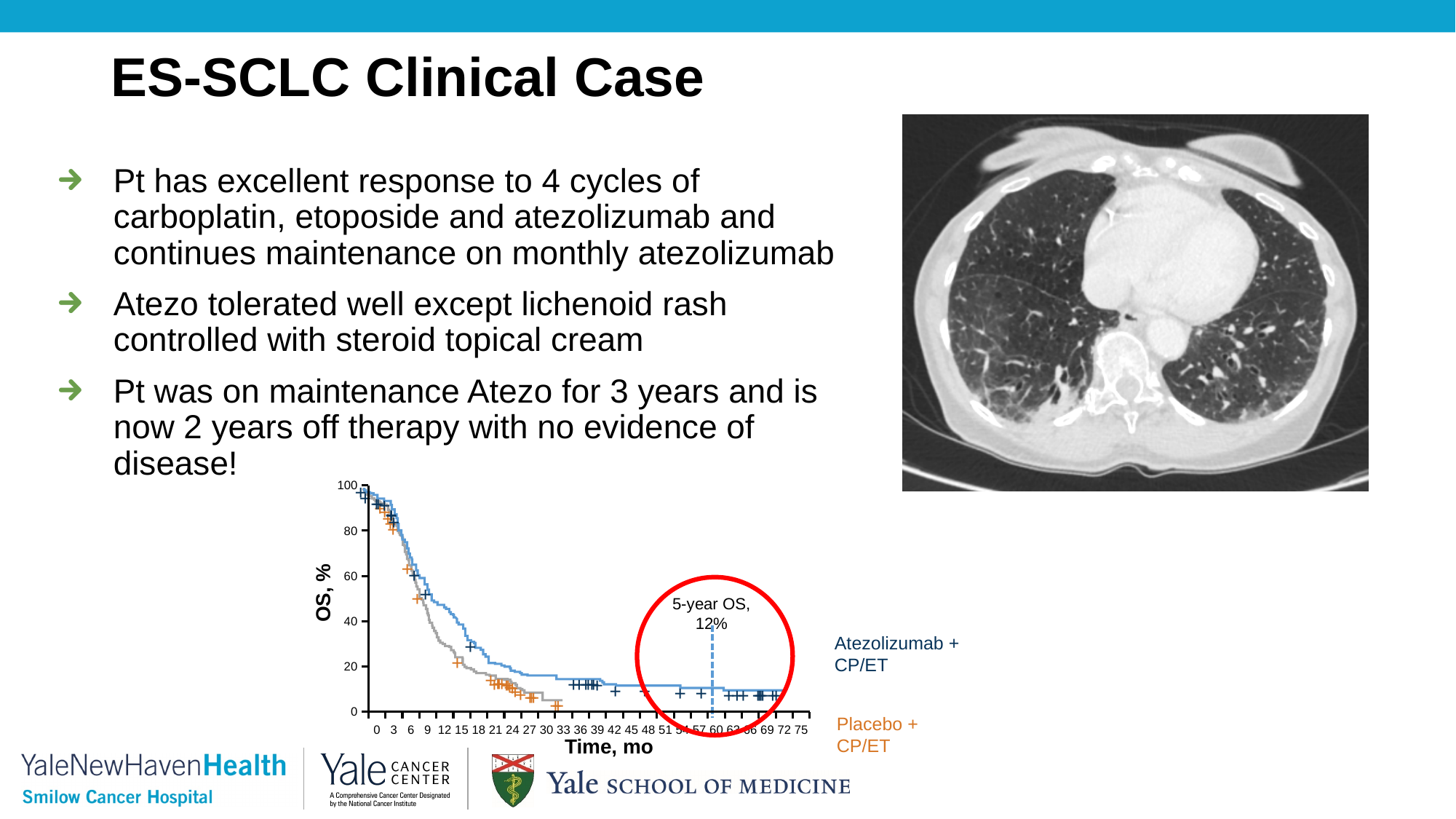
Is the OS value for Placebo + CP/ET at 30 months greater or less than 20? less What is the label of the y-axis on the survival chart? OS, % At 36 months, which series has the higher OS, Atezolizumab + CP/ET or Placebo + CP/ET? Atezolizumab + CP/ET Which series on the chart is labelled in orange text? Placebo + CP/ET Is the OS value for Atezolizumab + CP/ET at 60 months greater or less than 20? less At what time point (in months) is the dashed vertical line drawn on the chart? 60 Do the OS values rise or fall as time increases along the x axis? fall Is the OS value for Atezolizumab + CP/ET at 3 months greater or less than 80? greater What kind of chart is shown at the bottom of the slide? line chart What is the 5-year OS value highlighted in the red circle on the chart? 12% How many series (treatment arms) are shown on the survival chart? 2 What is the highest value shown on the x axis (Time, mo) of the chart? 75